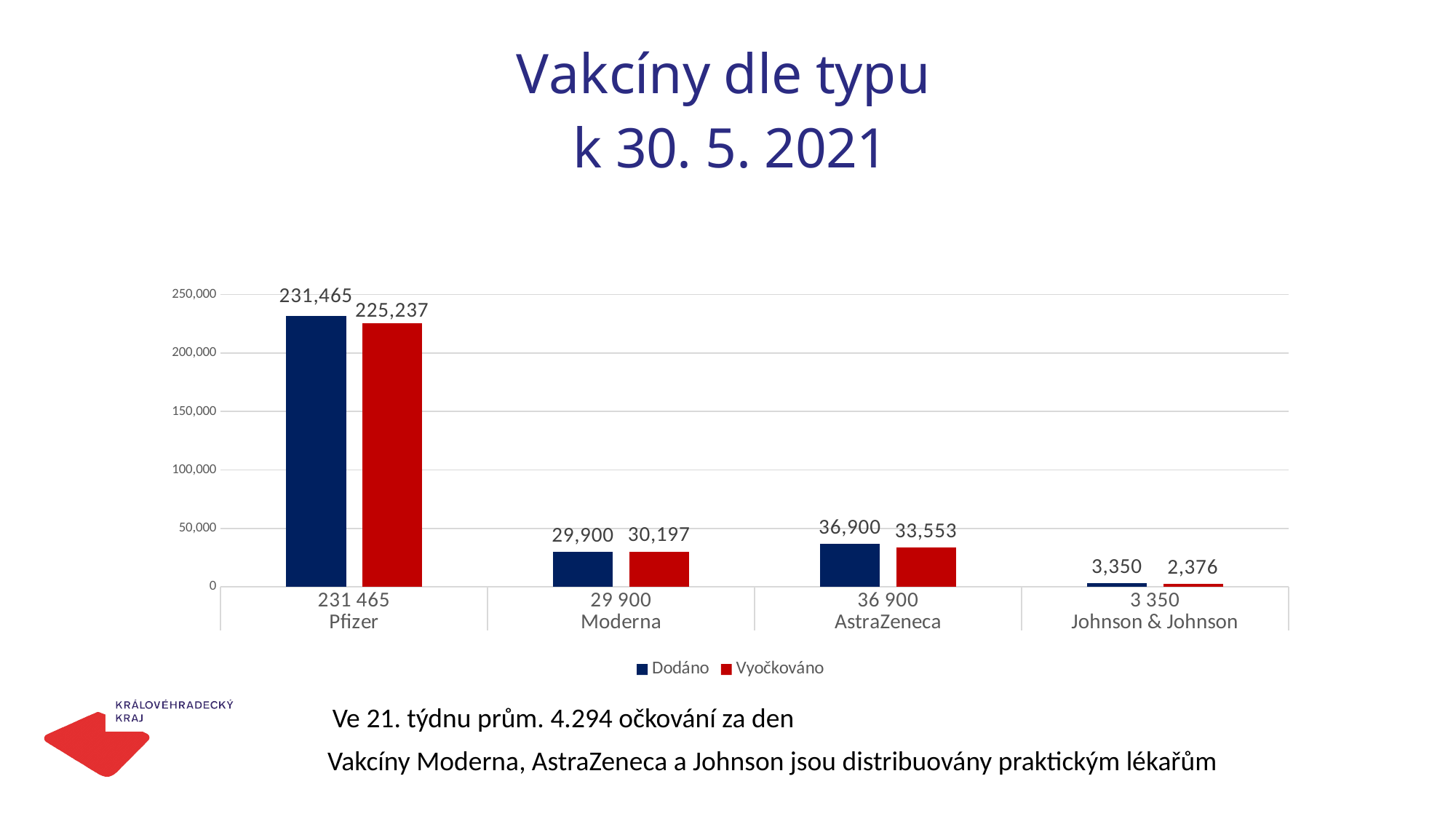
What is the Dodáno value for Johnson & Johnson? 3,350 How many vaccine types are shown on the x axis? 4 What is the difference between the Dodáno and Vyočkováno values for Pfizer? 6,228 Which vaccine has the lowest Vyočkováno value? Johnson & Johnson What is the difference between the Dodáno values for AstraZeneca and Moderna? 7,000 What is the Vyočkováno value for Moderna? 30,197 Which vaccine has the highest Dodáno value? Pfizer What kind of chart is shown on the slide? Bar chart How many series does the legend list? 2 What is the Dodáno value for Pfizer? 231,465 Which is larger for AstraZeneca, the Dodáno value or the Vyočkováno value? Dodáno What is the Vyočkováno value for AstraZeneca? 33,553